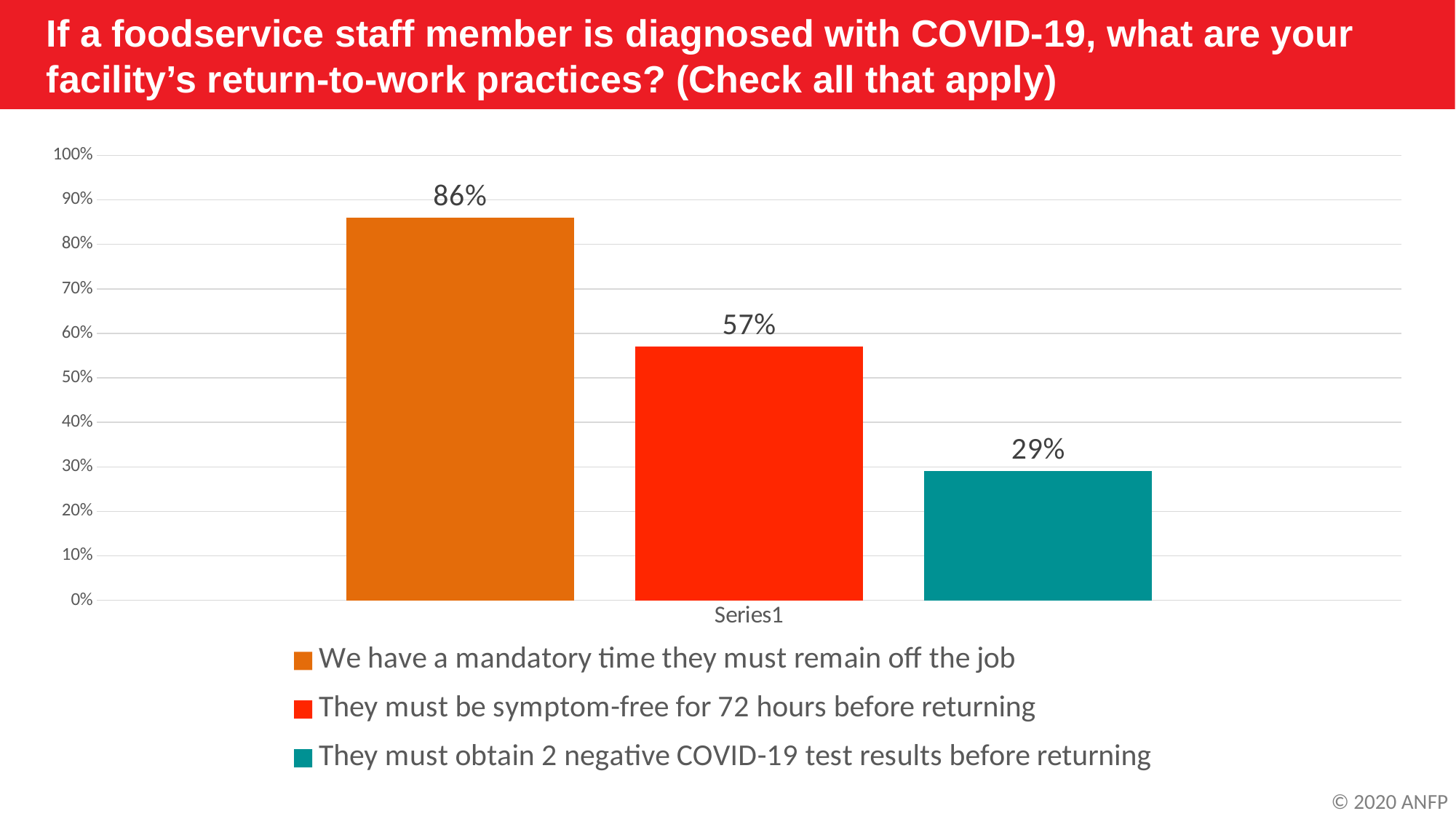
Which return-to-work practice has the highest percentage? We have a mandatory time they must remain off the job Which is larger: the percentage for symptom-free for 72 hours or the percentage for 2 negative COVID-19 test results? They must be symptom-free for 72 hours before returning Which return-to-work practice has the lowest percentage? They must obtain 2 negative COVID-19 test results before returning What colour is the bar for the 2 negative COVID-19 test results practice? Teal What kind of chart is shown on the slide? Bar chart What is the difference in percentage points between the 72-hour symptom-free practice and the 2 negative test results practice? 28 percentage points How many return-to-work practices are plotted in the chart? 3 Is the value for the 2 negative COVID-19 test results practice greater or less than 30%? less What percentage of respondents said staff must obtain 2 negative COVID-19 test results before returning? 29% What percentage of respondents said they have a mandatory time staff must remain off the job? 86% What is the difference in percentage points between the mandatory time off the job practice and the 72-hour symptom-free practice? 29 percentage points What percentage of respondents said staff must be symptom-free for 72 hours before returning? 57%